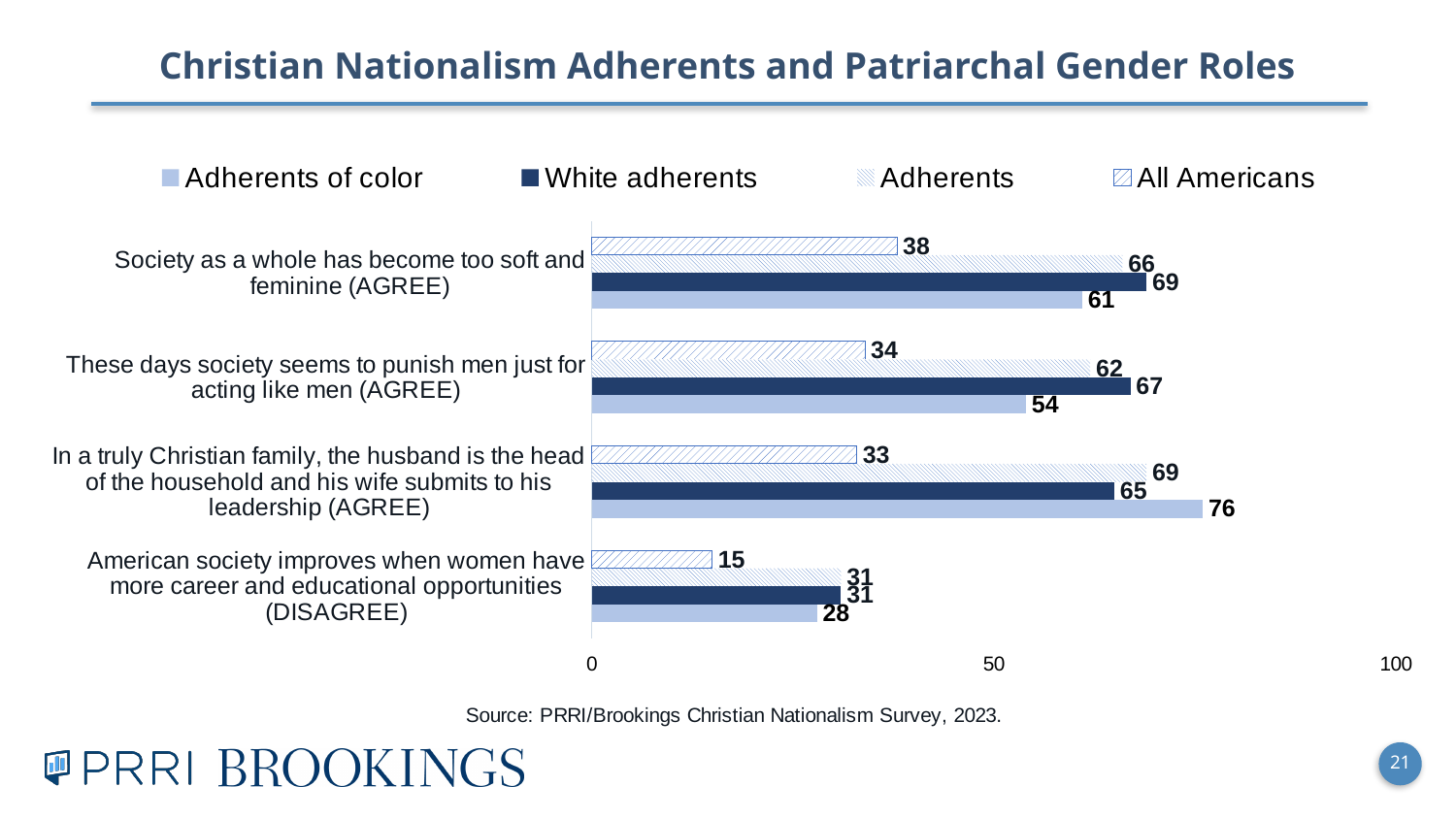
What is the value for Adherents on "American society improves when women have more career and educational opportunities (DISAGREE)"? 31 Which statement has the lowest value for All Americans? American society improves when women have more career and educational opportunities (DISAGREE) What is the value for All Americans on "Society as a whole has become too soft and feminine (AGREE)"? 38 How many series does the legend list? 4 What is the value for White adherents on "These days society seems to punish men just for acting like men (AGREE)"? 67 What is the value for Adherents of color on "In a truly Christian family, the husband is the head of the household and his wife submits to his leadership (AGREE)"? 76 Is the value for Adherents of color on "Society as a whole has become too soft and feminine (AGREE)" greater or less than 50? greater How many statements are shown on the chart? 4 Which series has the highest value on "In a truly Christian family, the husband is the head of the household and his wife submits to his leadership (AGREE)"? Adherents of color What is the difference between White adherents and All Americans on "Society as a whole has become too soft and feminine (AGREE)"? 31 Which is larger on "These days society seems to punish men just for acting like men (AGREE)": Adherents of color or White adherents? White adherents What kind of chart is shown on the slide? Bar chart